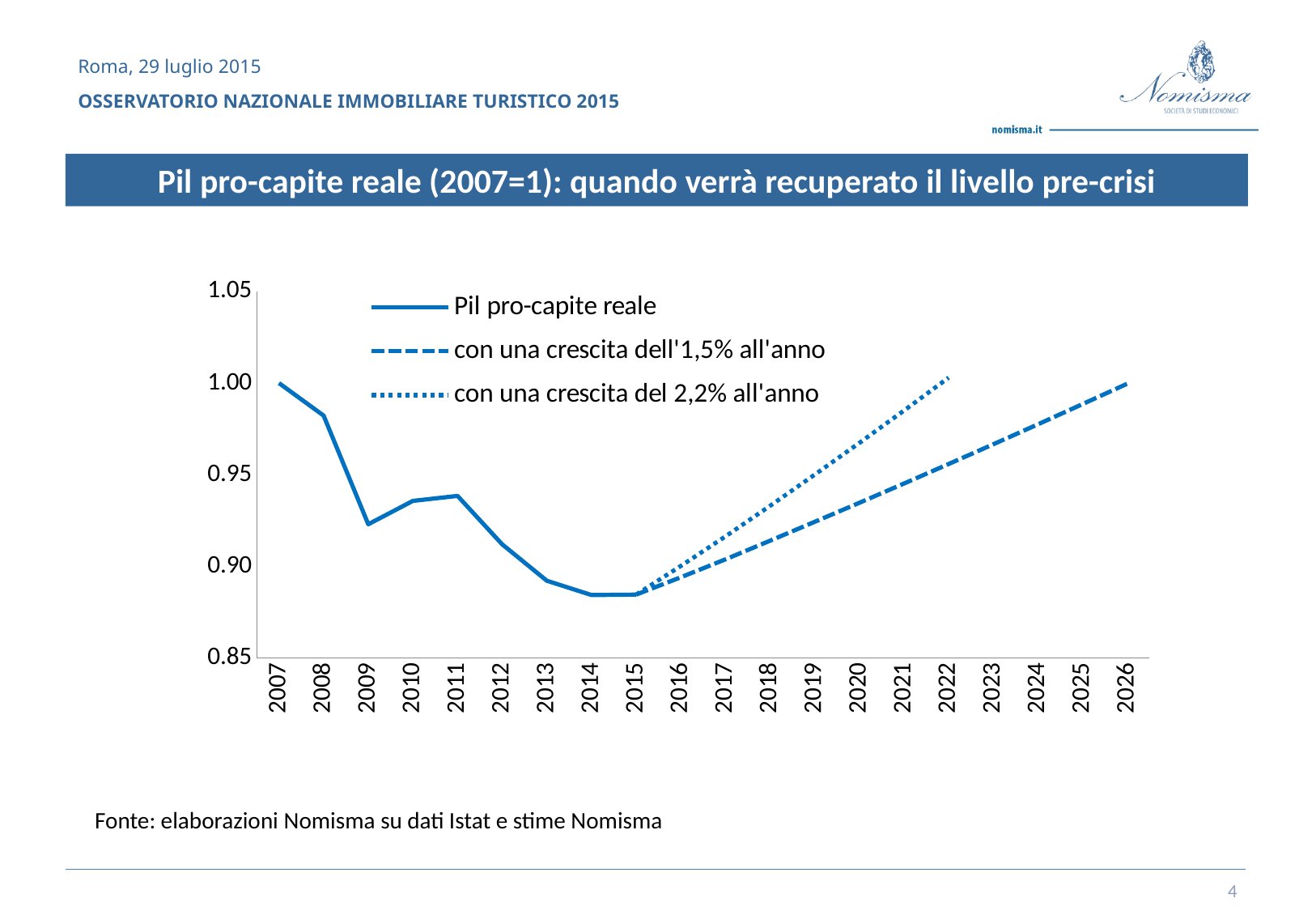
How many series does the legend list? 3 In which year is the Pil pro-capite reale line at its highest? 2007 What kind of chart is shown on the slide? line chart How many years are shown on the x axis? 20 Is the value of Pil pro-capite reale in 2009 greater or less than 0.95? less Is the value of Pil pro-capite reale in 2011 greater or less than 0.90? greater Which is larger, the Pil pro-capite reale value in 2010 or in 2012? 2010 Does the Pil pro-capite reale line rise or fall from 2007 to 2009? fall Is the value of Pil pro-capite reale in 2013 greater or less than 0.90? less In which year does the 'con una crescita del 2,2% all'anno' line end? 2022 What is the value of Pil pro-capite reale in 2007? 1.00 In 2020, which projection line is higher: the 1,5% growth line or the 2,2% growth line? con una crescita del 2,2% all'anno